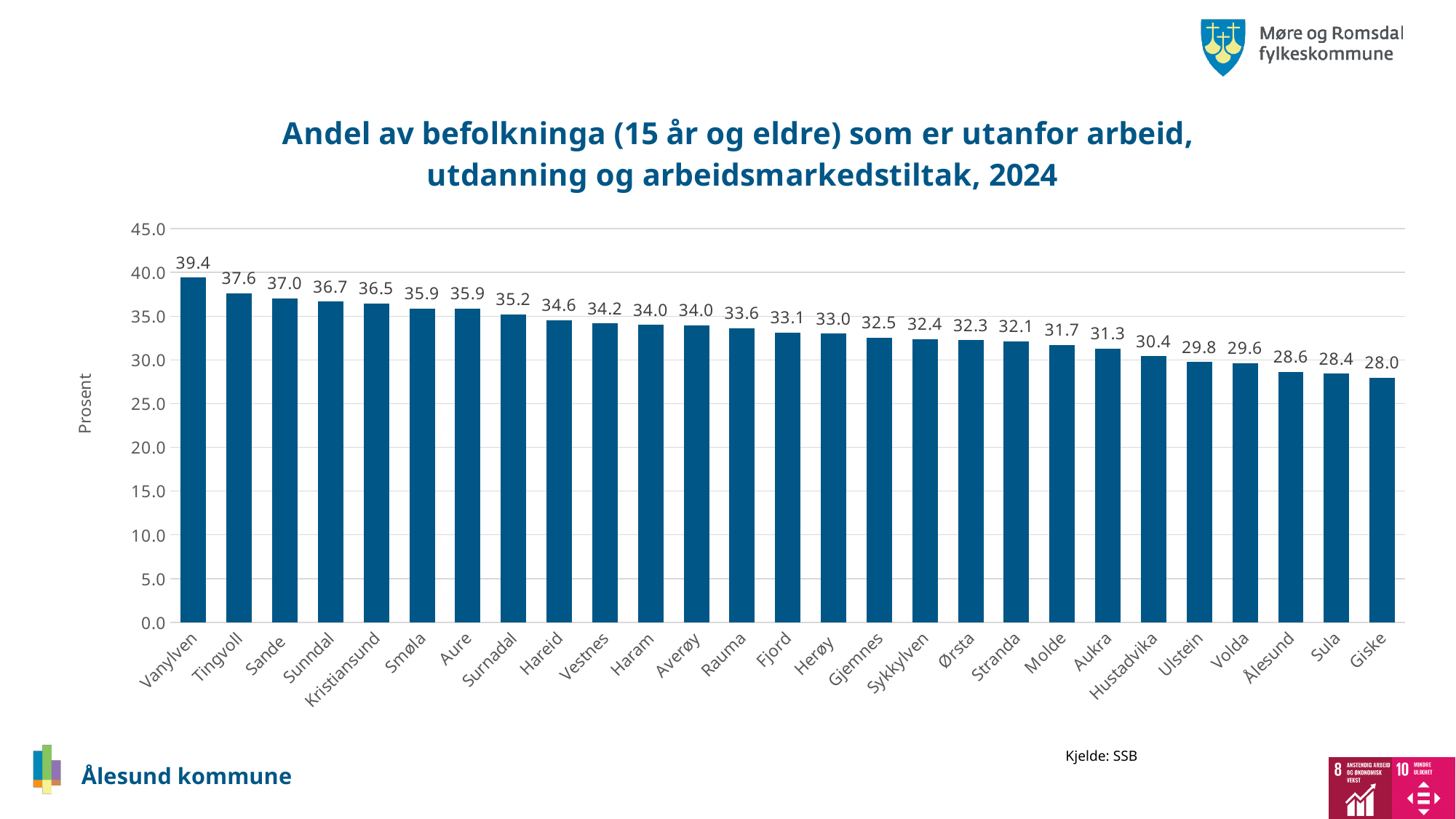
What kind of chart is shown on the slide? bar chart Which has a larger value, Kristiansund or Ulstein? Kristiansund Which municipality has the lowest value? Giske What is the value for Molde? 31.7 Is the value for Hustadvika greater or less than 35.0? less What is the difference between the values for Vanylven and Giske? 11.4 What is the value for Vanylven? 39.4 How many municipalities are shown on the chart? 27 What is the label of the vertical axis? Prosent What is the difference between the values for Tingvoll and Sande? 0.6 What is the value for Ålesund? 28.6 Which municipality has the highest value? Vanylven